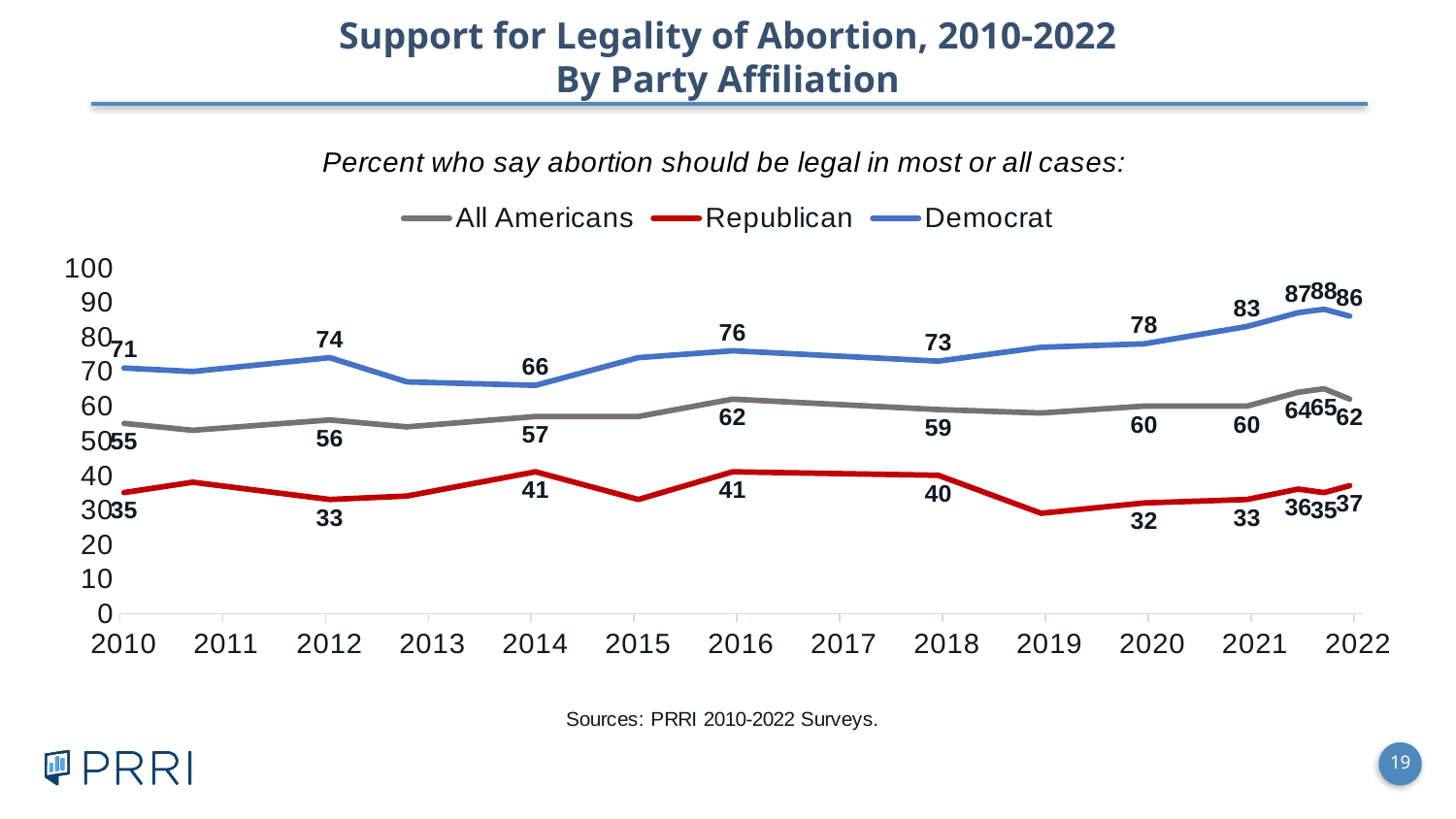
In 2014, which is higher: the Democrat value or the All Americans value? Democrat Among the labeled Republican values, which year has the lowest value? 2020 What percentage of Democrats said abortion should be legal in most or all cases in 2010? 71 What is the Democrat value in 2020? 78 Does the Democrat line generally rise or fall from 2010 to 2022? Rise Is the Democrat value for 2015 greater or less than 70? greater Which series is drawn in red? Republican What is the Republican value in 2012? 33 What kind of chart is shown on the slide? Line chart In 2018, how many points higher is the Democrat value than the Republican value? 33 How many series does the legend list? 3 What is the All Americans value in 2016? 62